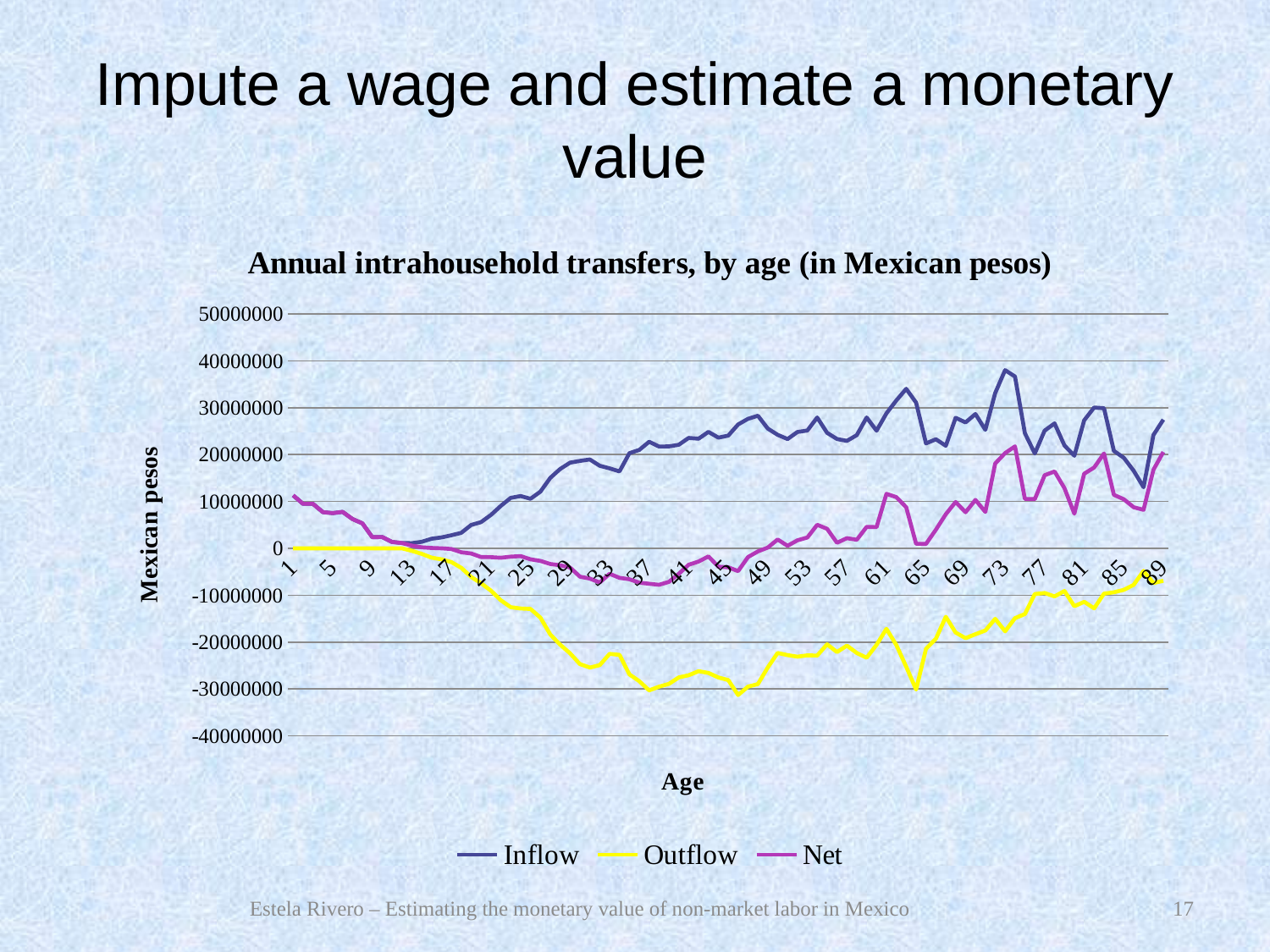
What is the title of the chart? Annual intrahousehold transfers, by age (in Mexican pesos) Is the Net value at age 37 greater or less than 0? less What are the series names listed in the legend? Inflow, Outflow, Net Is the Inflow value at age 73 greater or less than 30000000? greater How many series does the legend list? 3 At age 73, which is larger, Inflow or Net? Inflow Which series has the lowest value at age 49? Outflow Is the Outflow value at age 49 greater or less than -20000000? less Does the Inflow series rise or fall between age 1 and age 29? rise What kind of chart is shown on the slide? line chart Does the Outflow series rise or fall between age 13 and age 37? fall